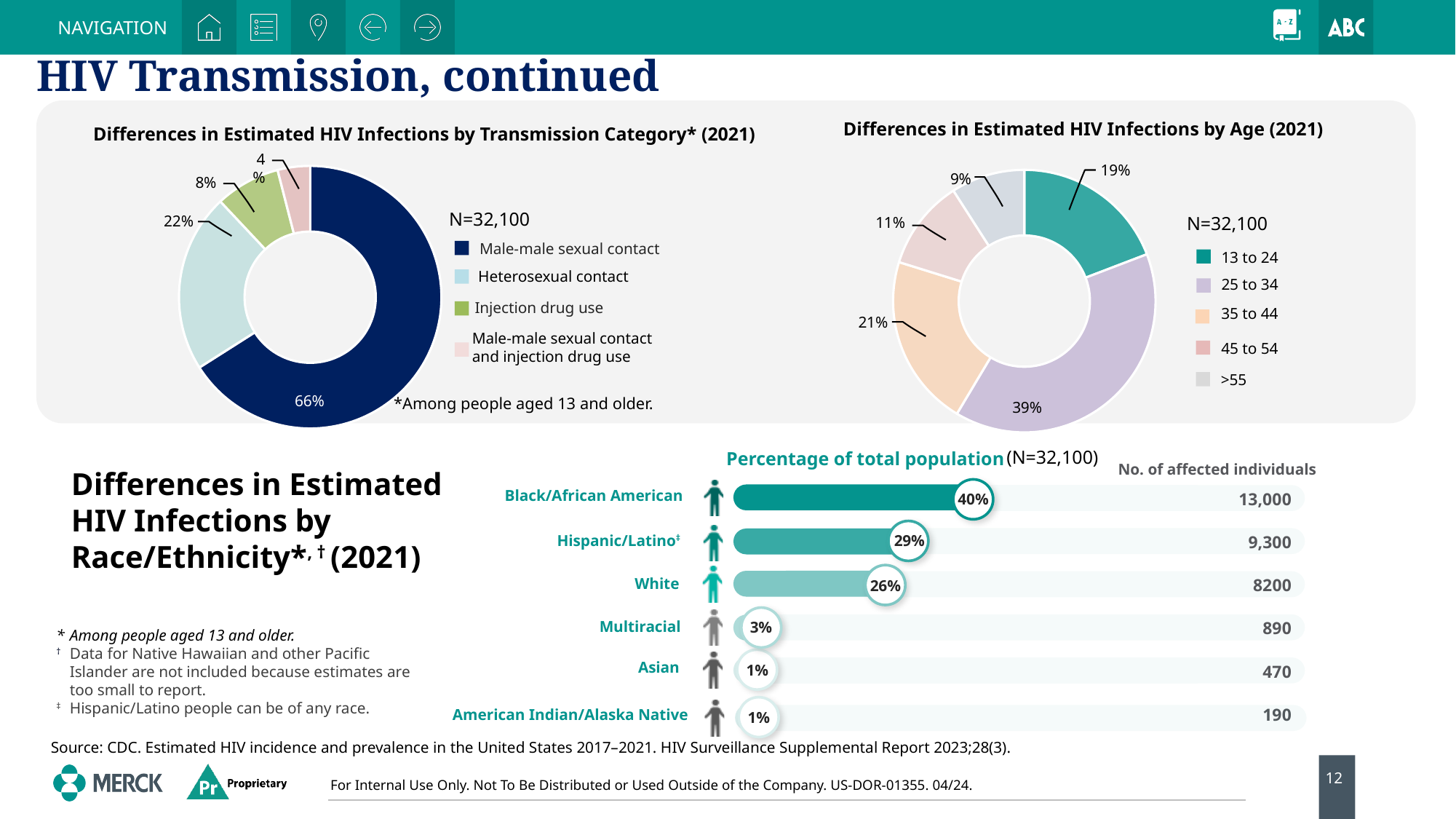
In the 'Differences in Estimated HIV Infections by Age' chart, which age group has the lowest share? >55 In the 'Differences in Estimated HIV Infections by Race/Ethnicity' chart, what percentage of the total population is Hispanic/Latino? 29% In the 'Differences in Estimated HIV Infections by Age' chart, what percentage is shown for the 25 to 34 age group? 39% In the 'Differences in Estimated HIV Infections by Transmission Category' chart, what percentage is attributed to male-male sexual contact? 66% In the 'Differences in Estimated HIV Infections by Transmission Category' chart, what is the difference in percentage points between heterosexual contact and injection drug use? 14 percentage points How many race/ethnicity categories are shown in the 'Differences in Estimated HIV Infections by Race/Ethnicity' chart? 6 In the 'Differences in Estimated HIV Infections by Race/Ethnicity' chart, which race/ethnicity group has the highest percentage? Black/African American In the 'Differences in Estimated HIV Infections by Age' chart, which is larger: the share for 13 to 24 or the share for 35 to 44? 35 to 44 In the 'Differences in Estimated HIV Infections by Transmission Category' chart, which transmission category has the smallest share? Male-male sexual contact and injection drug use How many age groups does the legend of the 'Differences in Estimated HIV Infections by Age' chart list? 5 What kind of chart is 'Differences in Estimated HIV Infections by Age (2021)'? Donut (pie) chart In the 'Differences in Estimated HIV Infections by Race/Ethnicity' chart, how many affected individuals are listed for White? 8200